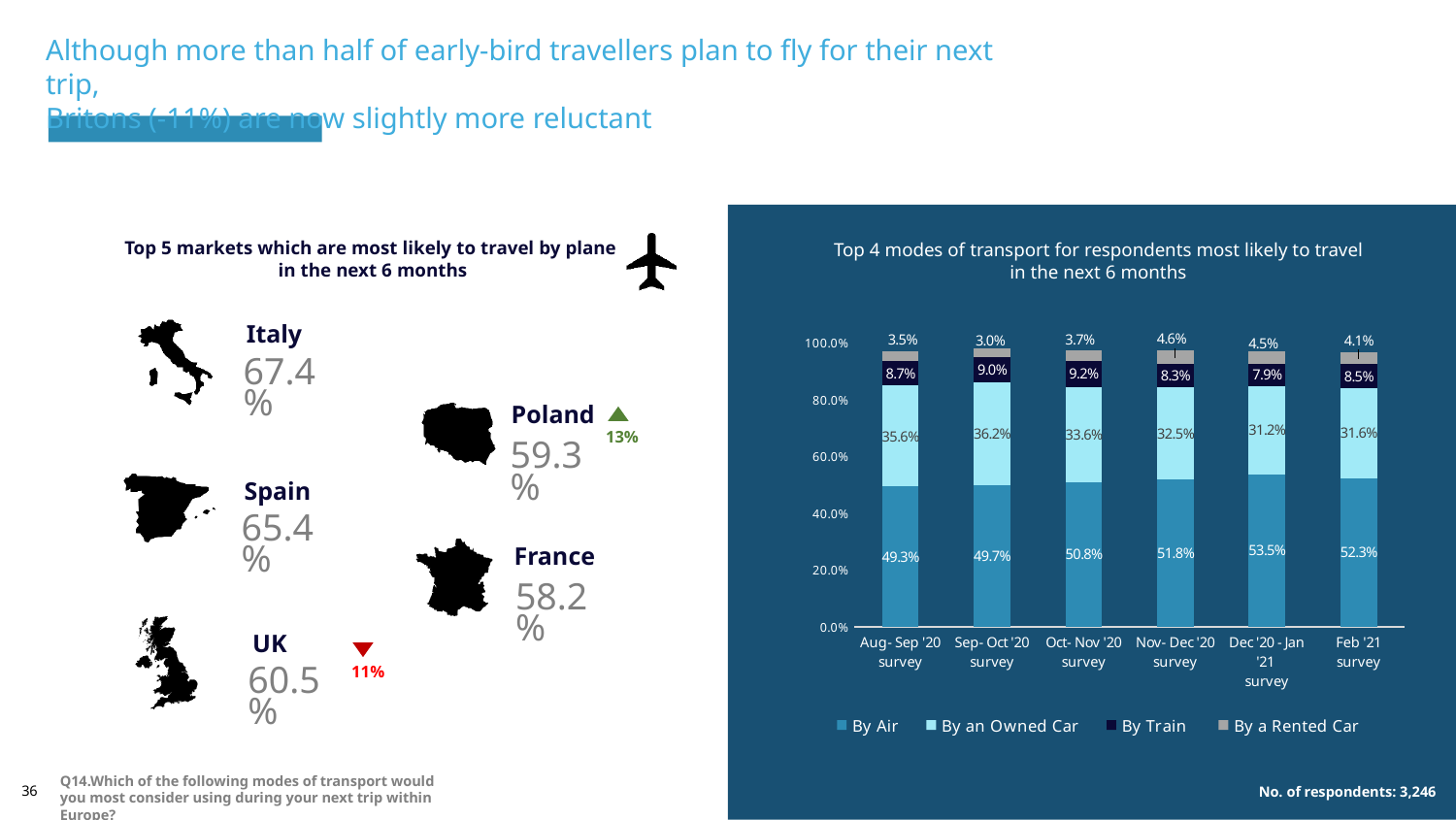
Which survey has the larger By Air share: Oct-Nov '20 or Nov-Dec '20? Nov-Dec '20 survey In which survey is the By Train share the highest? Oct-Nov '20 survey How many modes of transport does the legend list? 4 By how many percentage points did the By an Owned Car share change between the Aug-Sep '20 survey (35.6%) and the Feb '21 survey (31.6%)? 4.0 percentage points What is the By Train value for the Oct-Nov '20 survey? 9.2% What percentage of respondents chose By Air in the Feb '21 survey? 52.3% Does the By Air share generally rise or fall from the Aug-Sep '20 survey to the Feb '21 survey? Rise How many survey periods are shown on the x axis of the chart? 6 What is the By a Rented Car value in the Nov-Dec '20 survey? 4.6% In which survey is the By a Rented Car share the lowest? Sep-Oct '20 survey What type of chart is used to show the top 4 modes of transport? Stacked bar chart In which survey is the By Air share the highest? Dec '20 - Jan '21 survey